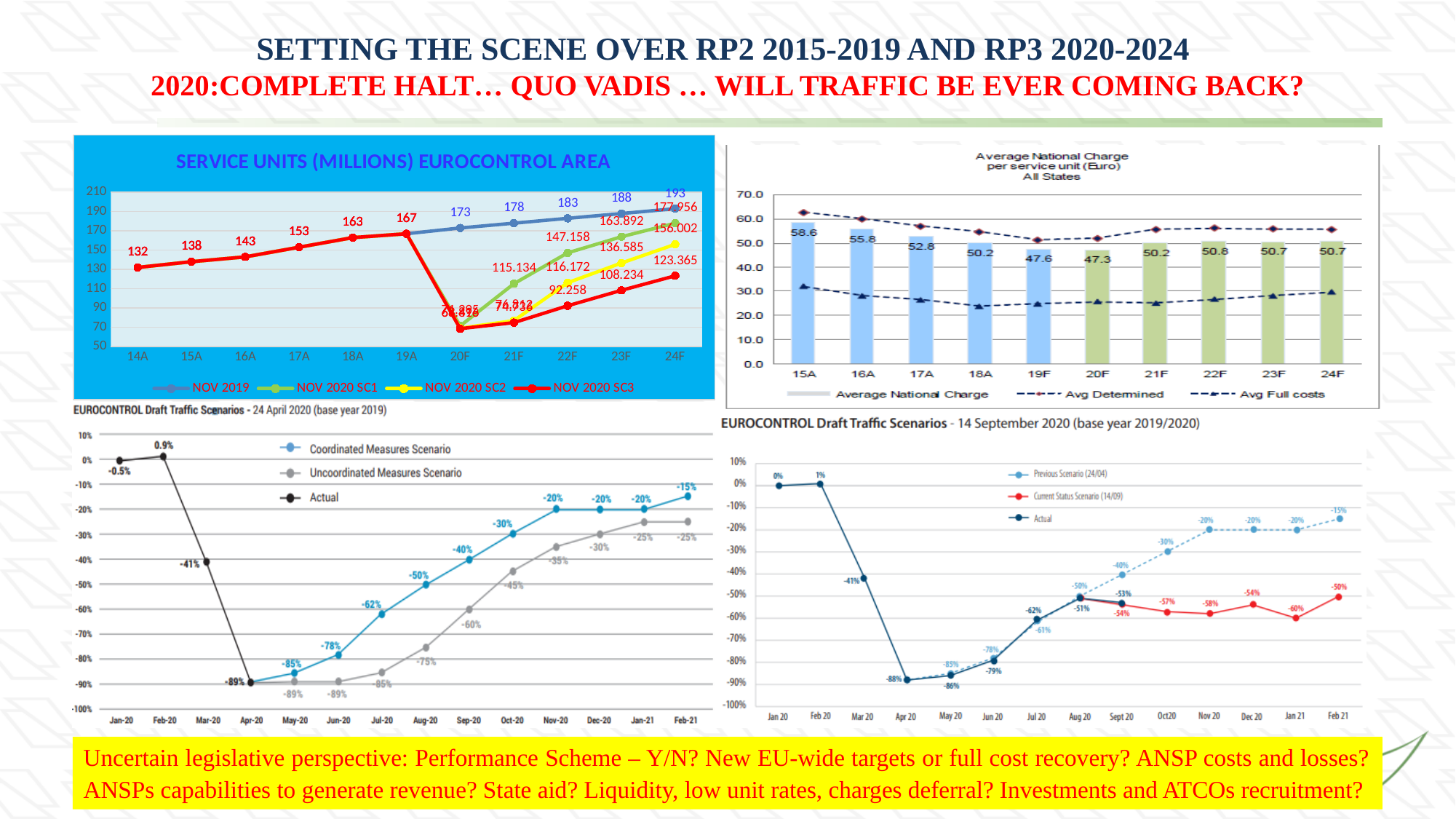
In the 'EUROCONTROL Draft Traffic Scenarios - 24 April 2020' chart, what is the Actual value for Apr-20? -89% In the 'EUROCONTROL Draft Traffic Scenarios - 14 September 2020' chart, which is larger at Feb 21: the Previous Scenario value or the Current Status Scenario value? Previous Scenario In the 'Average National Charge per service unit (Euro) All States' chart, which year has the lowest Average National Charge bar? 20F In the 'SERVICE UNITS (MILLIONS) EUROCONTROL AREA' chart, what is the NOV 2019 value at 24F? 193 How many bars are shown in the 'Average National Charge per service unit (Euro) All States' chart? 10 How many series does the legend of the 'SERVICE UNITS (MILLIONS) EUROCONTROL AREA' chart list? 4 In the 'EUROCONTROL Draft Traffic Scenarios - 14 September 2020' chart, what is the Current Status Scenario value for Jan 21? -60% In the 'EUROCONTROL Draft Traffic Scenarios - 24 April 2020' chart, what is the Uncoordinated Measures Scenario value for Sep-20? -60% In the 'Average National Charge per service unit (Euro) All States' chart, what is the difference between the 15A and 19F bar values? 11.0 In the 'SERVICE UNITS (MILLIONS) EUROCONTROL AREA' chart, what is the NOV 2020 SC3 value at 24F? 123.365 In the 'Average National Charge per service unit (Euro) All States' chart, which year has the highest Average National Charge bar? 15A In the 'SERVICE UNITS (MILLIONS) EUROCONTROL AREA' chart, what is the value for 19A? 167